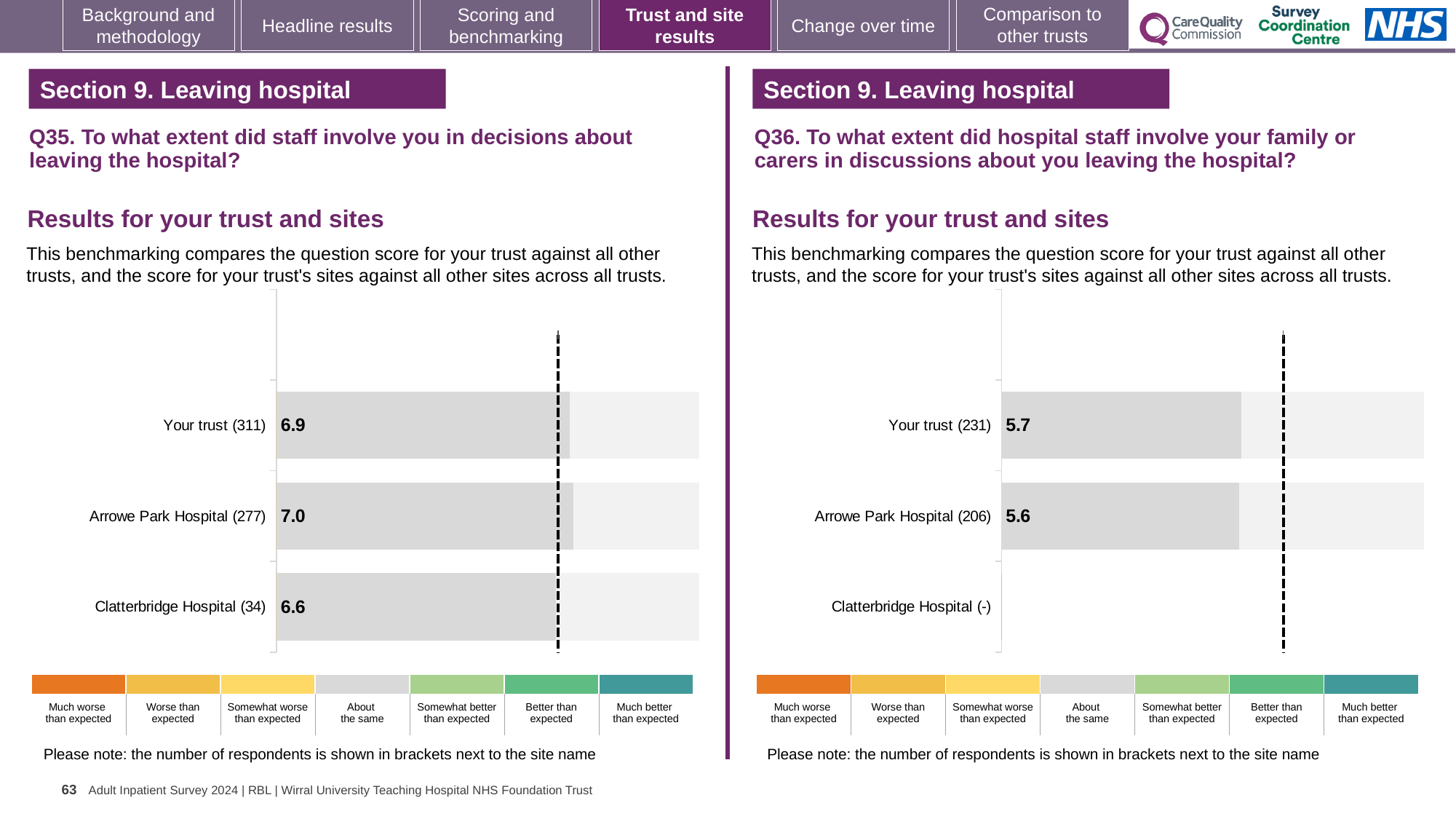
In the Q36 chart on the right, how many categories are listed on the vertical axis? 3 In the Q35 chart on the left, what is the difference between the scores for Arrowe Park Hospital and Clatterbridge Hospital? 0.4 In the Q35 chart on the left, how many respondents are shown for Clatterbridge Hospital? 34 In the Q36 chart on the right, what is the difference between the scores for Your trust and Arrowe Park Hospital? 0.1 In the Q36 chart on the right, what is the score for Your trust? 5.7 In the Q35 chart on the left, which site or trust has the highest score? Arrowe Park Hospital In the Q35 chart on the left, what is the score for Your trust? 6.9 In the Q35 chart on the left, which site or trust has the lowest score? Clatterbridge Hospital In the Q35 chart on the left, what is the score for Clatterbridge Hospital? 6.6 What kind of chart is used on the left for Q35? Bar chart In the Q36 chart on the right, what is the score for Arrowe Park Hospital? 5.6 In the Q35 chart on the left, what is the score for Arrowe Park Hospital? 7.0